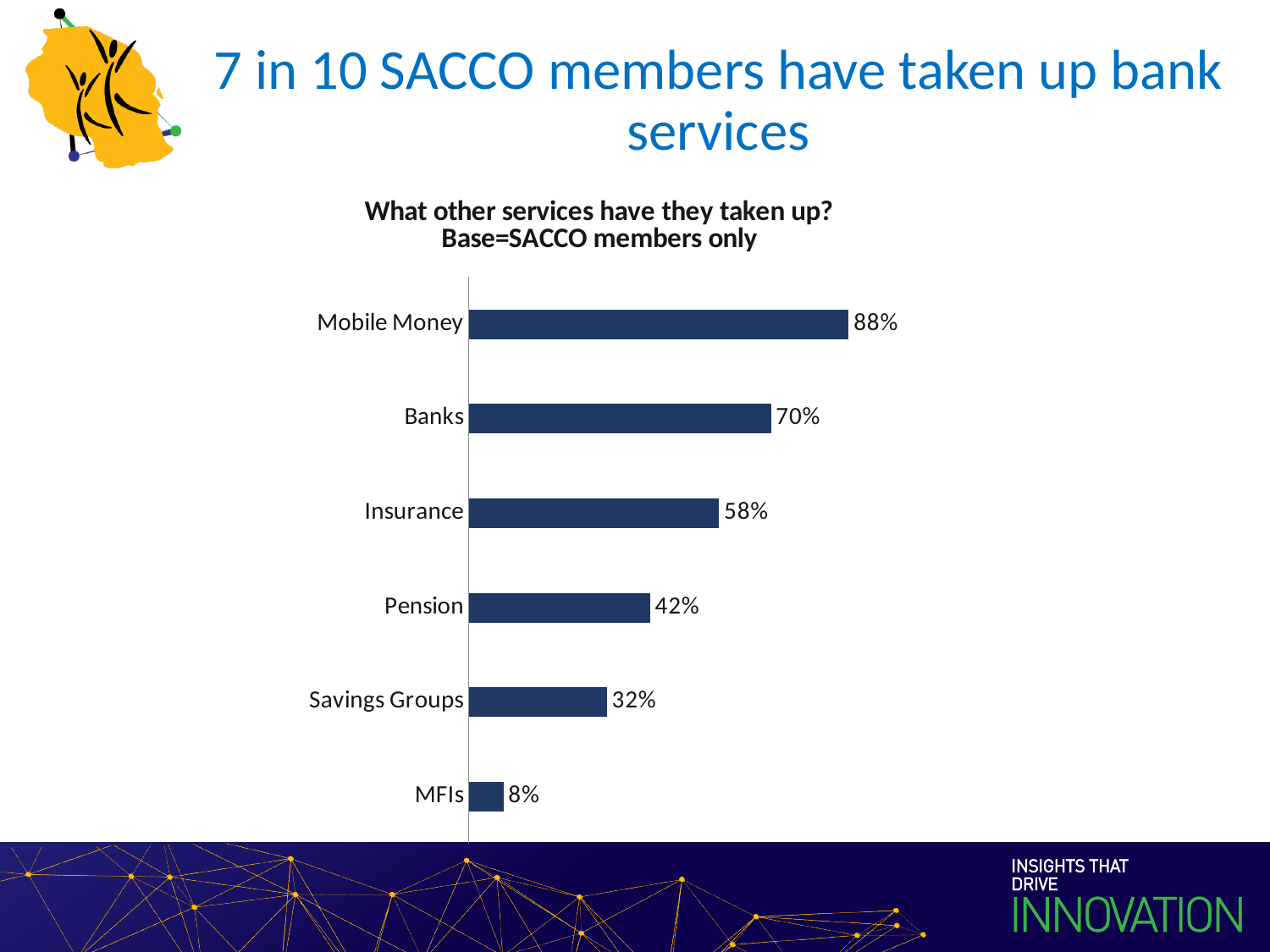
What type of chart is shown on the slide? Bar chart Which has a higher value, Insurance or Savings Groups? Insurance What percentage of SACCO members have taken up Mobile Money? 88% What is the difference between the values for Banks and Pension? 28% How many service categories are shown in the chart? 6 Which service has the lowest uptake among SACCO members? MFIs What is the difference between the values for Mobile Money and MFIs? 80% What is the value shown for Pension? 42% What is the title of the chart? What other services have they taken up? Base=SACCO members only What is the value shown for Insurance? 58% Which service has the highest uptake among SACCO members? Mobile Money What percentage of SACCO members have taken up Savings Groups? 32%